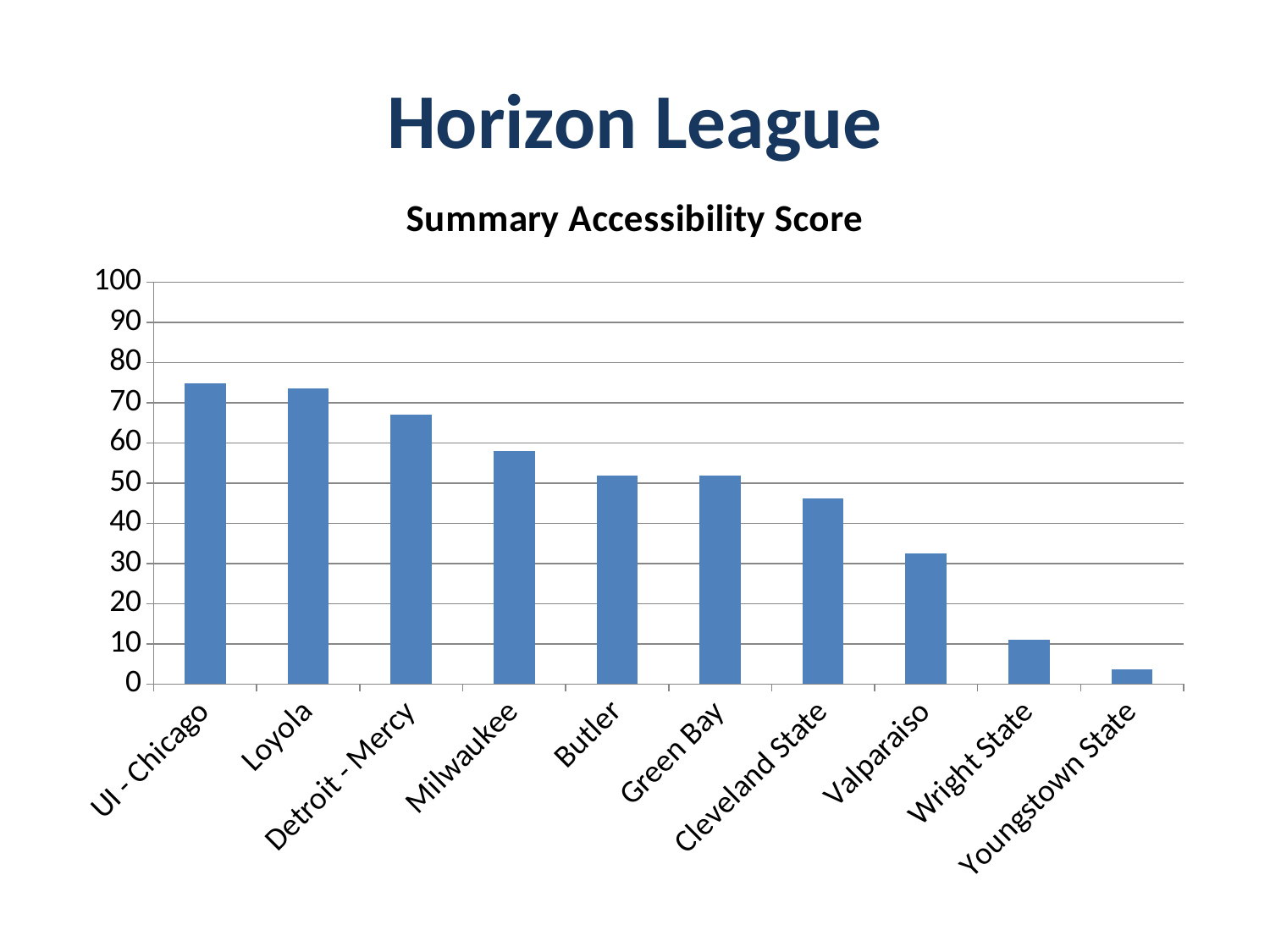
Is the value for Milwaukee greater or less than 50? greater What is the title of the chart? Summary Accessibility Score Is the value for Wright State greater or less than 20? less Is the value for Valparaiso greater or less than 40? less What kind of chart is shown on the slide? bar chart How many schools are shown on the x axis of the chart? 10 Do the values generally rise or fall moving from left to right along the x axis? fall Which school has the lowest Summary Accessibility Score? Youngstown State What is the maximum value shown on the vertical axis? 100 Which has the larger Summary Accessibility Score, Cleveland State or Valparaiso? Cleveland State Which school has the highest Summary Accessibility Score? UI - Chicago